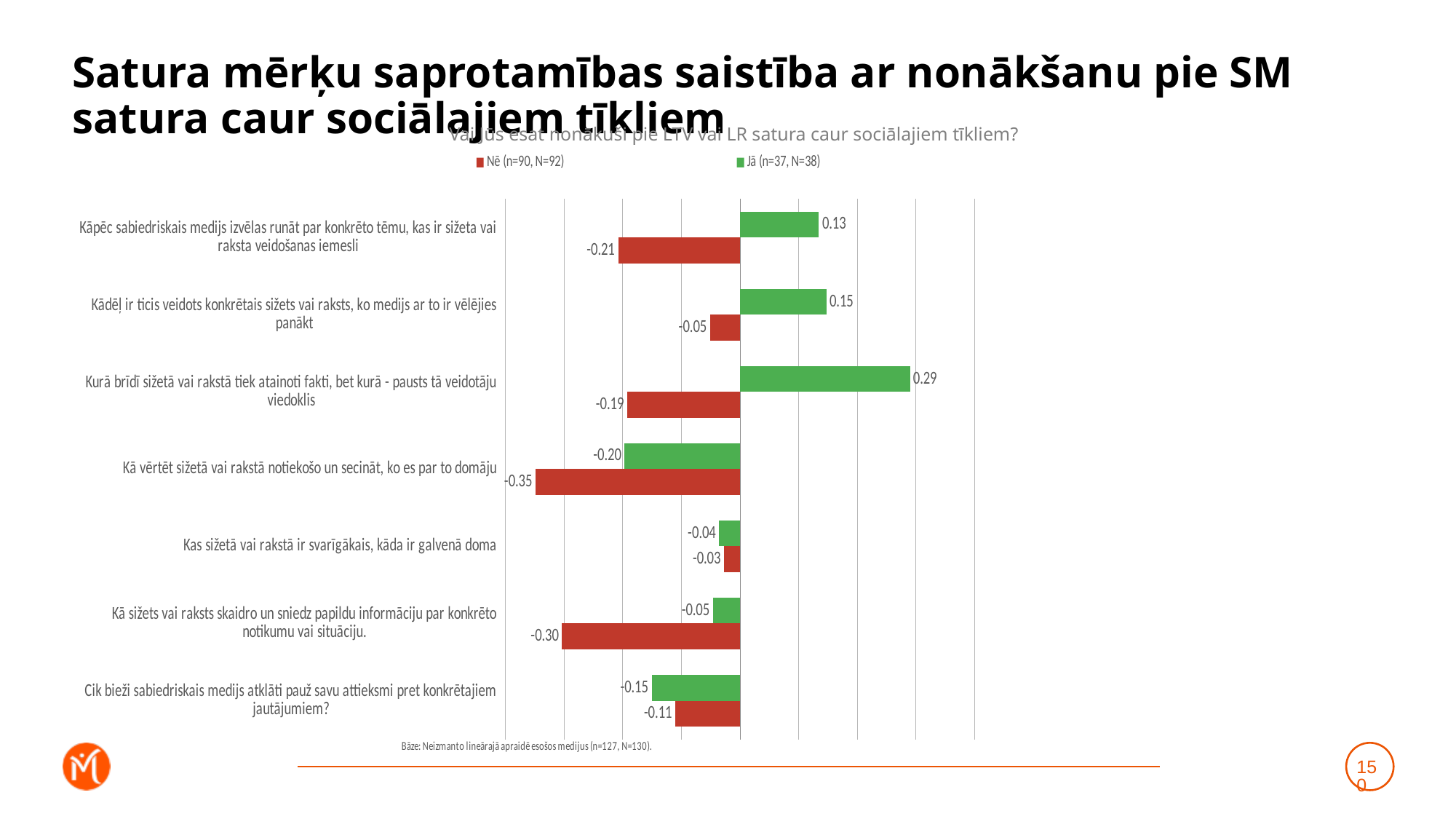
What is the value of the Nē series for "Kā sižets vai raksts skaidro un sniedz papildu informāciju par konkrēto notikumu vai situāciju."? -0.30 How many categories (statements) are plotted on the chart? 7 What is the value of the Nē series for "Kā vērtēt sižetā vai rakstā notiekošo un secināt, ko es par to domāju"? -0.35 For "Kādēļ ir ticis veidots konkrētais sižets vai raksts, ko medijs ar to ir vēlējies panākt", which series has the larger value, Jā or Nē? Jā What is the value of the Jā series for "Kurā brīdī sižetā vai rakstā tiek atainoti fakti, bet kurā - pausts tā veidotāju viedoklis"? 0.29 How many series does the legend list? 2 What is the difference between the Jā value (0.13) and the Nē value (-0.21) for "Kāpēc sabiedriskais medijs izvēlas runāt par konkrēto tēmu, kas ir sižeta vai raksta veidošanas iemesli"? 0.34 What is the value of the Jā series for "Cik bieži sabiedriskais medijs atklāti pauž savu attieksmi pret konkrētajiem jautājumiem?"? -0.15 What colour represents the Nē series in the chart? red Which category has the lowest value in the Nē series? Kā vērtēt sižetā vai rakstā notiekošo un secināt, ko es par to domāju What kind of chart is shown on the slide? bar chart Which category has the highest value in the Jā series? Kurā brīdī sižetā vai rakstā tiek atainoti fakti, bet kurā - pausts tā veidotāju viedoklis